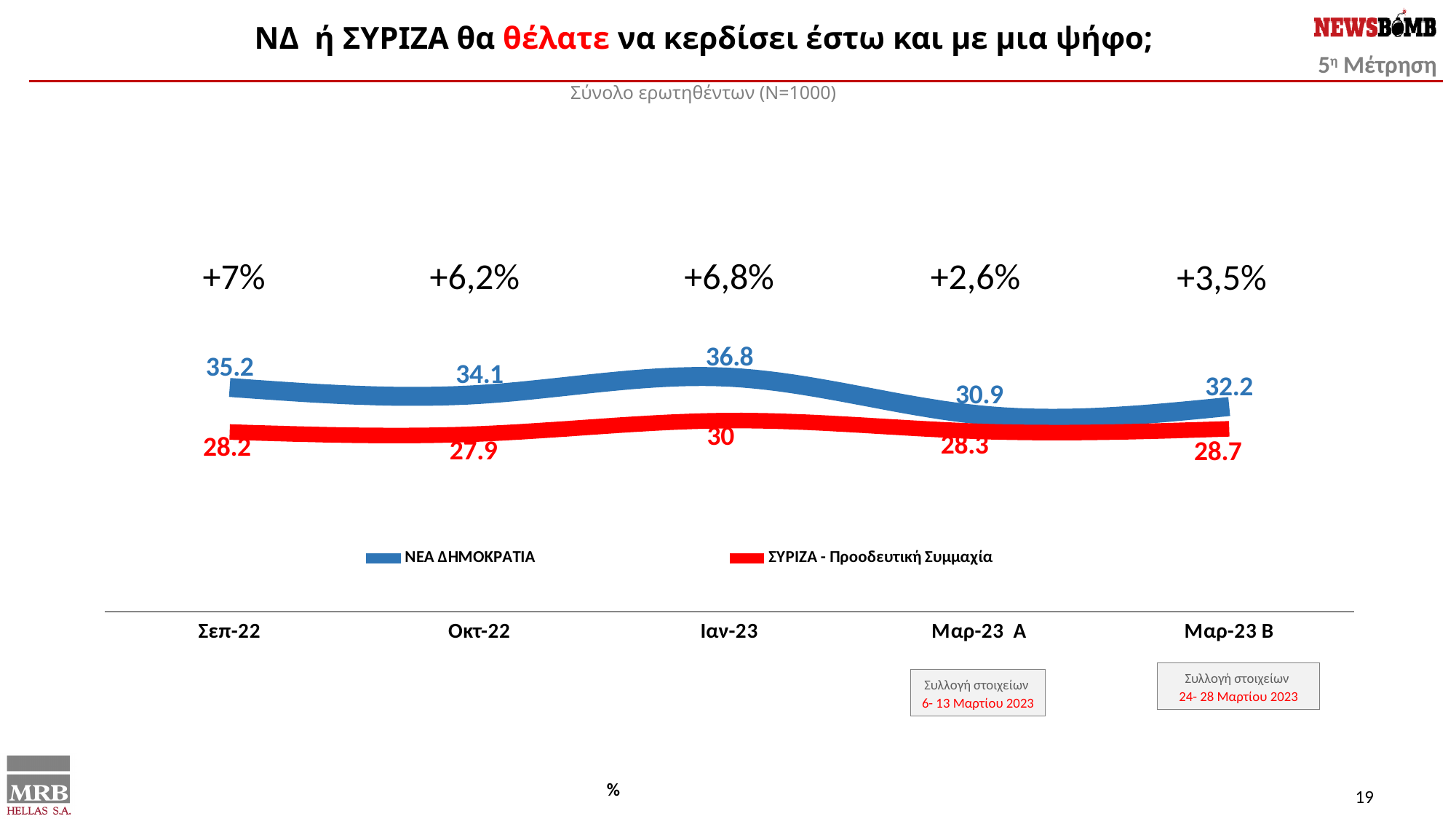
How many series does the legend list? 2 Does the value for ΝΕΑ ΔΗΜΟΚΡΑΤΙΑ rise or fall from Ιαν-23 to Μαρ-23 Α? Fall At which time point does ΝΕΑ ΔΗΜΟΚΡΑΤΙΑ have its lowest value? Μαρ-23 Α At which time point does ΝΕΑ ΔΗΜΟΚΡΑΤΙΑ reach its highest value? Ιαν-23 How many time points are plotted on the x axis? 5 What is the value for ΣΥΡΙΖΑ - Προοδευτική Συμμαχία at Οκτ-22? 27.9 At which time point does ΣΥΡΙΖΑ - Προοδευτική Συμμαχία have its lowest value? Οκτ-22 What is the difference between ΝΕΑ ΔΗΜΟΚΡΑΤΙΑ and ΣΥΡΙΖΑ - Προοδευτική Συμμαχία at Σεπ-22? 7 What is the value for ΝΕΑ ΔΗΜΟΚΡΑΤΙΑ at Ιαν-23? 36.8 What kind of chart is shown on the slide? Line chart Which series has the higher value at Μαρ-23 Α? ΝΕΑ ΔΗΜΟΚΡΑΤΙΑ What is the value for ΝΕΑ ΔΗΜΟΚΡΑΤΙΑ at Μαρ-23 Β? 32.2